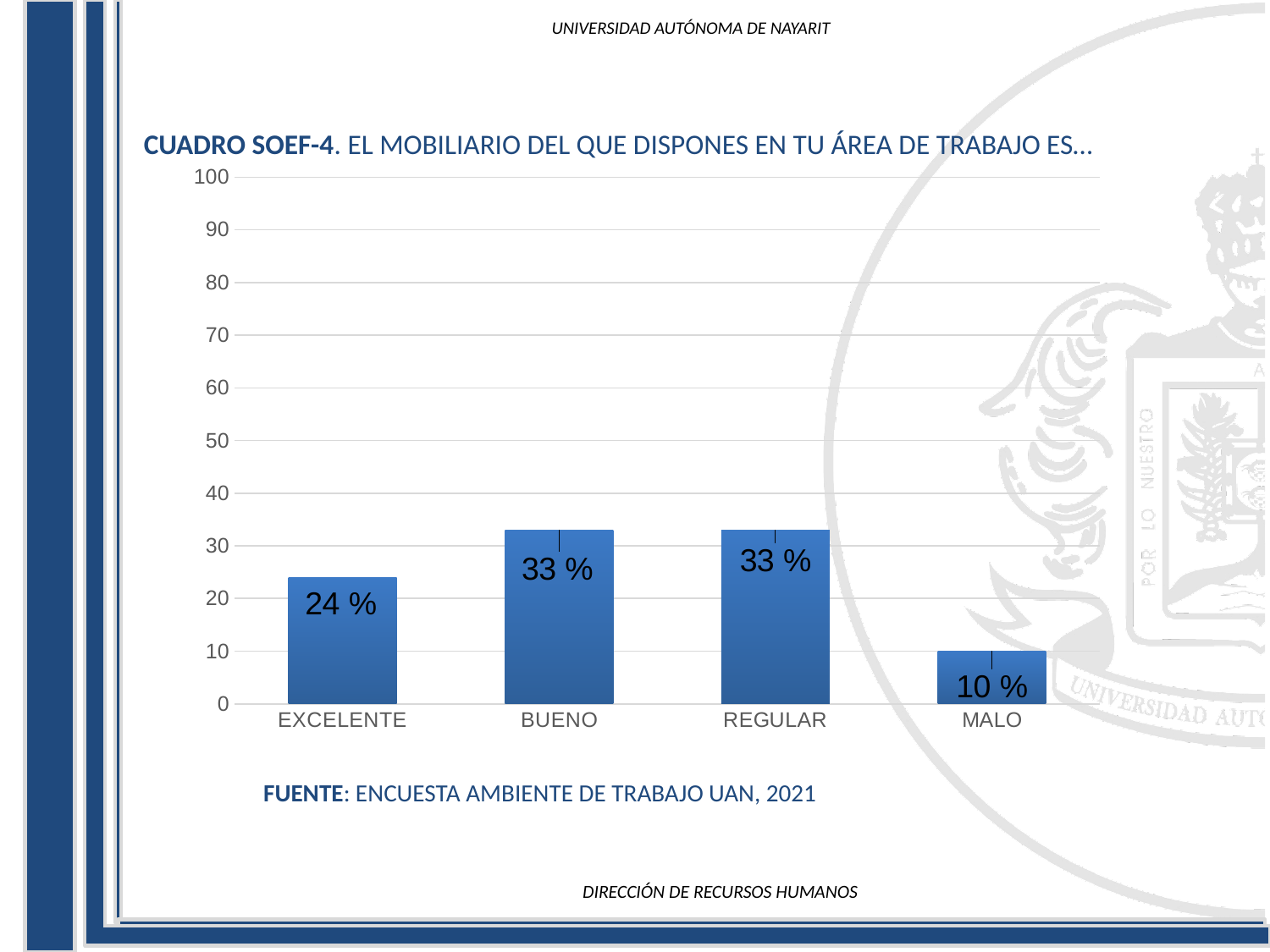
Is the value for REGULAR greater or less than 30? greater What is the value for MALO? 10 % Which is larger, the value for EXCELENTE or the value for MALO? EXCELENTE What is the value for EXCELENTE? 24 % What is the source cited below the chart? ENCUESTA AMBIENTE DE TRABAJO UAN, 2021 What is the value for BUENO? 33 % What is the difference between the values for EXCELENTE and MALO? 14 % What kind of chart is shown on the slide? bar chart Is the value for EXCELENTE greater or less than 30? less What is the difference between the values for BUENO and EXCELENTE? 9 % How many categories are shown on the x axis? 4 Which category has the lowest value? MALO